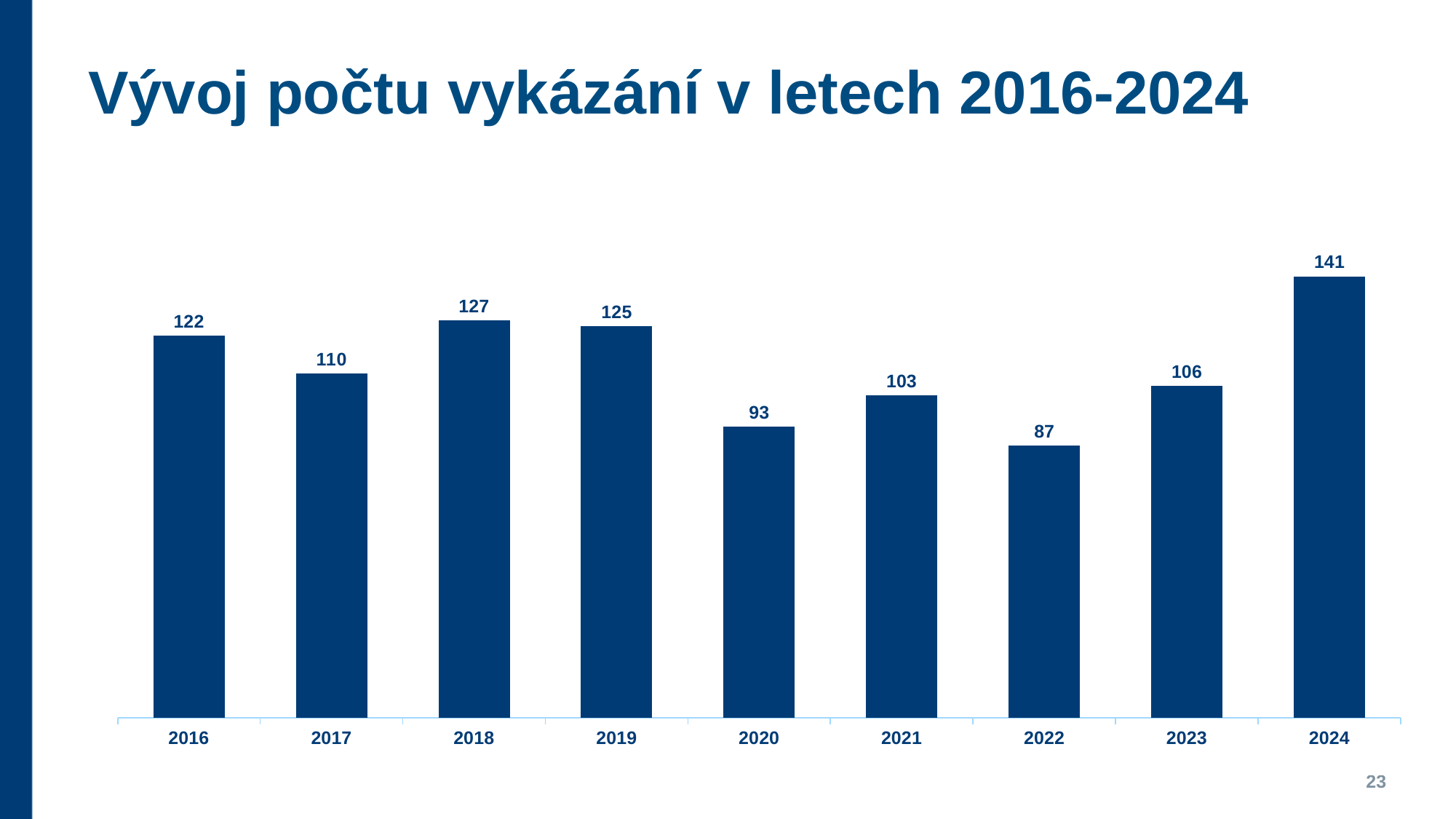
What is the title of the chart? Vývoj počtu vykázání v letech 2016-2024 What kind of chart is shown on the slide? Bar chart What is the value for 2020? 93 What is the difference between the values for 2018 and 2017? 17 Do the values rise or fall from 2022 to 2024? Rise What is the value for 2023? 106 Which year has the lowest value? 2022 Which year has the highest value? 2024 How many years are shown on the x axis? 9 What is the difference between the values for 2024 and 2022? 54 What is the value for 2016? 122 Which is larger, the value for 2019 or the value for 2021? 2019